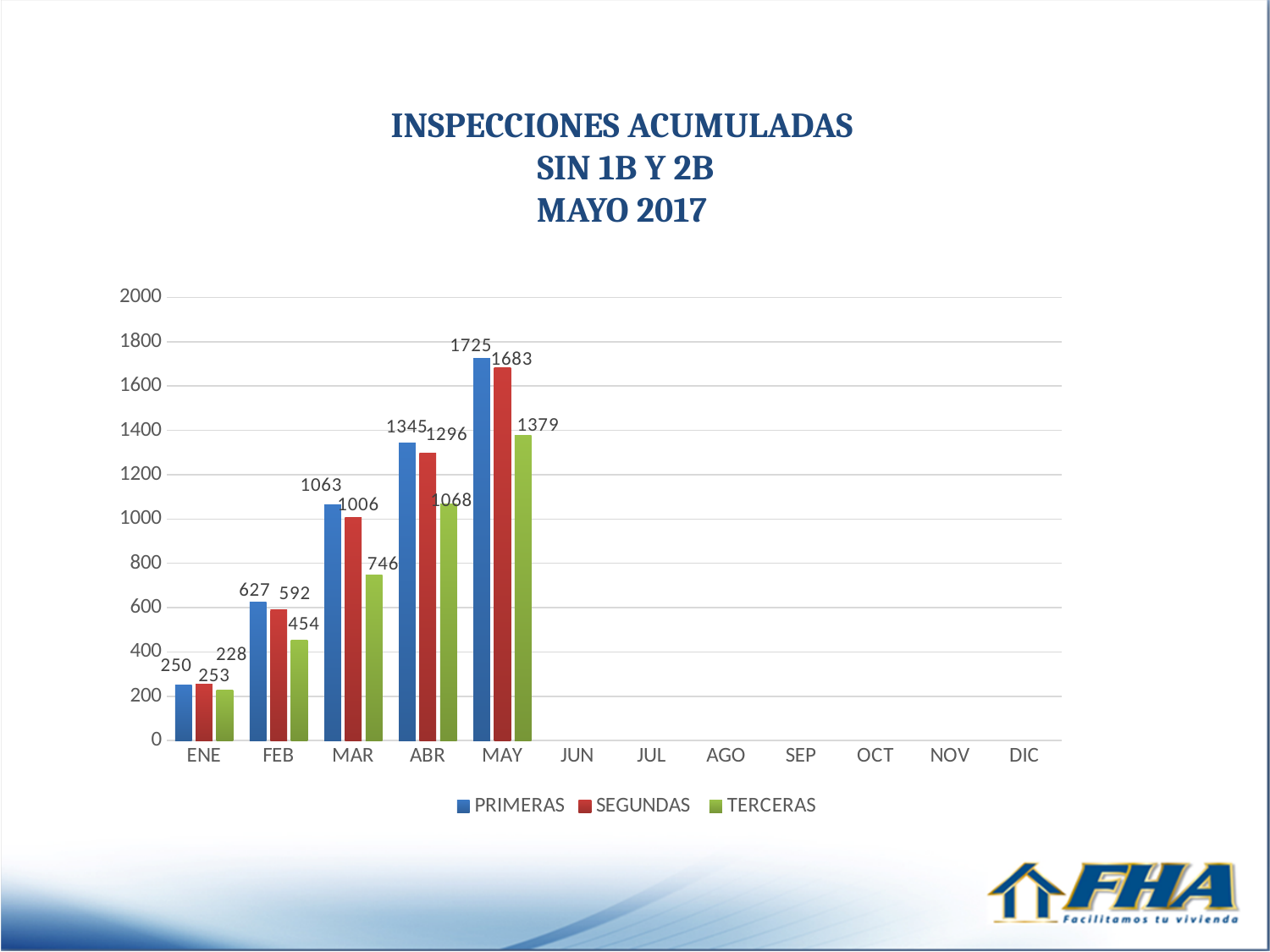
What kind of chart is shown on the slide? Bar chart What is the value for SEGUNDAS in FEB? 592 What is the value for PRIMERAS in MAY? 1725 Do the PRIMERAS values rise or fall from ENE to MAY? Rise How many series does the legend list? 3 What is the value for TERCERAS in MAR? 746 In which month is the TERCERAS value lowest? ENE In which month is the PRIMERAS value highest? MAY Which is larger in ENE, PRIMERAS or SEGUNDAS? SEGUNDAS What is the difference between PRIMERAS and SEGUNDAS in MAY? 42 How many months are shown on the x axis? 12 What is the difference between SEGUNDAS and TERCERAS in ABR? 228